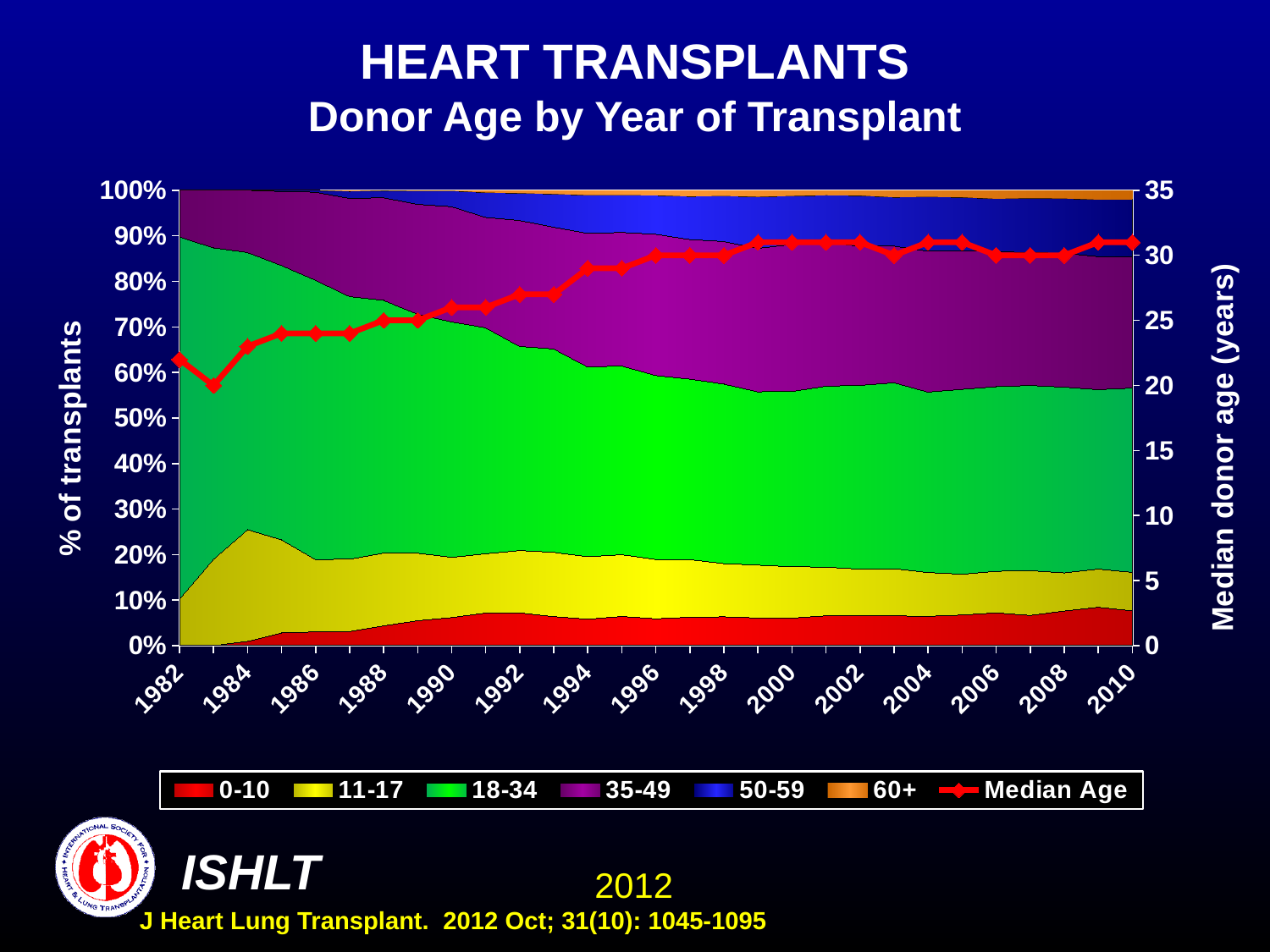
In 1982, which donor age group has the larger share of transplants, 18-34 or 35-49? 18-34 How many year labels are shown on the x axis? 15 Is the Median Age value for 1982 greater or less than 25 years? less Is the Median Age value for 1983 greater or less than 25 years? less What kind of chart is this? Stacked area chart with a line Is the Median Age value for 2000 greater or less than 25 years? greater What is the title of the chart? HEART TRANSPLANTS Donor Age by Year of Transplant Which donor age group accounts for the largest share of transplants in 2010? 18-34 How many series does the legend list? 7 What is the label of the right-hand y axis? Median donor age (years) Does the Median Age line rise or fall from 1982 to 2010? rises